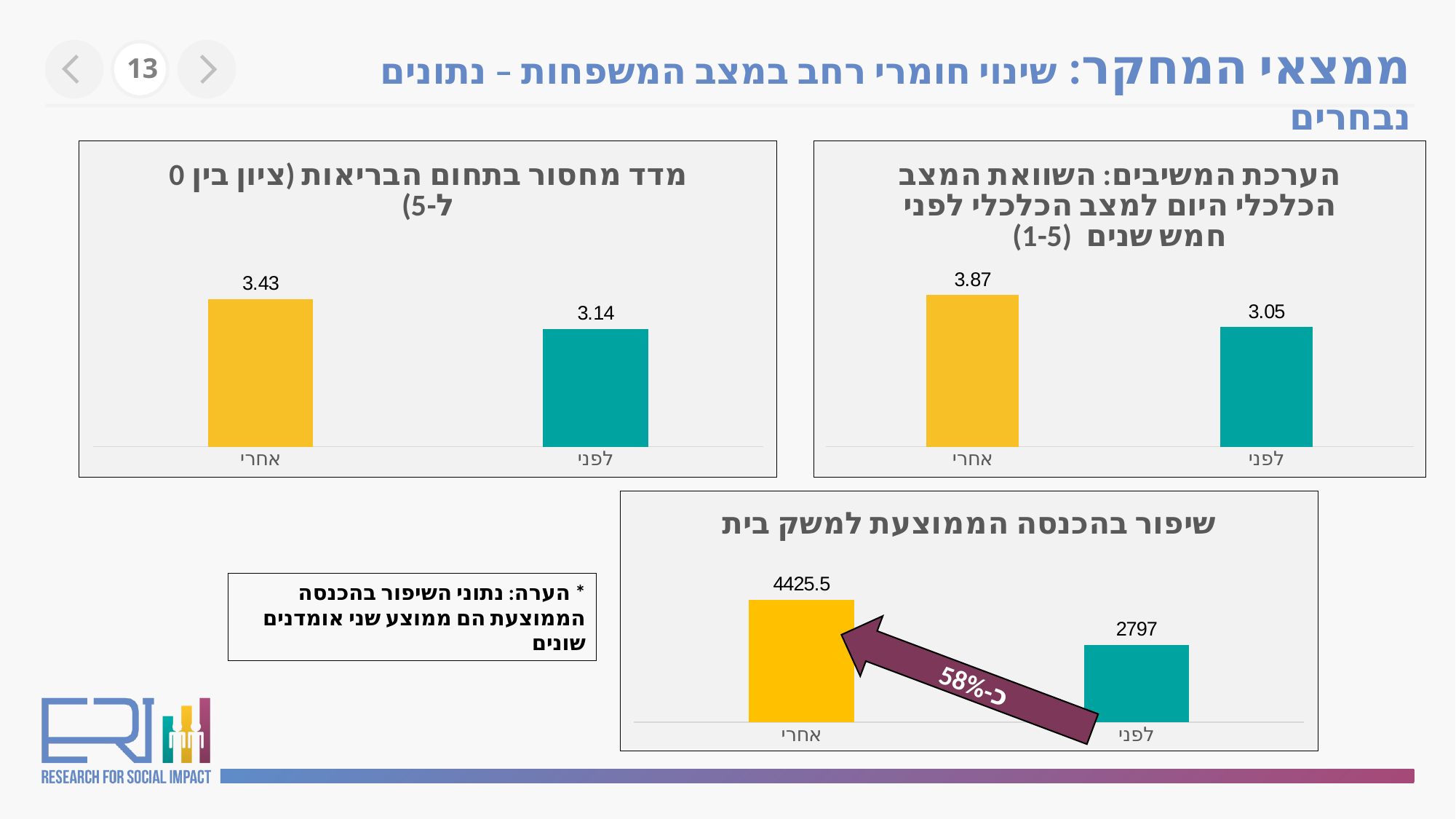
In the top-left chart (מדד מחסור בתחום הבריאות), what is the value for אחרי? 3.43 In the top-right chart (הערכת המשיבים), what is the value for לפני? 3.05 How many bars does the bottom chart (שיפור בהכנסה הממוצעת למשק בית) show? 2 In the bottom chart (שיפור בהכנסה הממוצעת למשק בית), what is the value for אחרי? 4425.5 What type of chart is the top-left chart (מדד מחסור בתחום הבריאות)? Bar chart In the bottom chart (שיפור בהכנסה הממוצעת למשק בית), which category has the lower value? לפני In the top-right chart (הערכת המשיבים), which category has the higher value? אחרי In the top-left chart (מדד מחסור בתחום הבריאות), what is the difference between the אחרי and לפני values? 0.29 In the bottom chart (שיפור בהכנסה הממוצעת למשק בית), what is the value for לפני? 2797 In the top-left chart (מדד מחסור בתחום הבריאות), what is the value for לפני? 3.14 In the top-right chart (הערכת המשיבים), what is the value for אחרי? 3.87 In the top-right chart (הערכת המשיבים), what is the difference between the אחרי and לפני values? 0.82